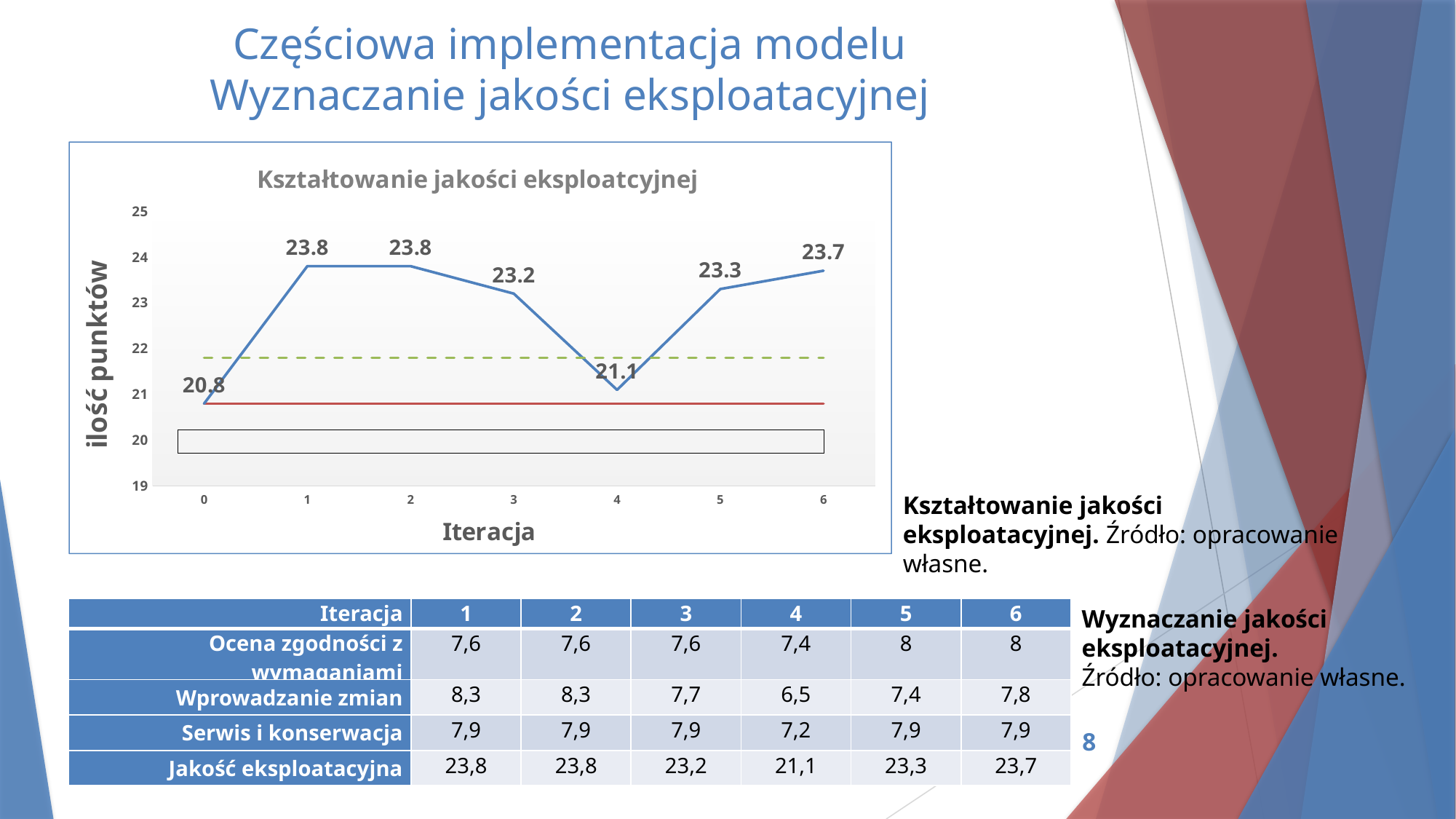
What is the difference between the values at iteration 3 and iteration 4? 2.1 What is the value of the blue line at iteration 3? 23.2 At which iteration does the blue line reach its lowest labelled value? 0 What is the value of the blue line at iteration 0? 20.8 What type of chart is shown on the slide? line chart Does the blue line rise or fall between iteration 4 and iteration 5? rise Which is larger, the value at iteration 5 or the value at iteration 6? iteration 6 How many labelled data points does the blue line have? 7 What is the value of the blue line at iteration 6? 23.7 What is the highest labelled value on the blue line? 23.8 What is the title of the chart? Kształtowanie jakości eksploatcyjnej What is the value of the blue line at iteration 4? 21.1